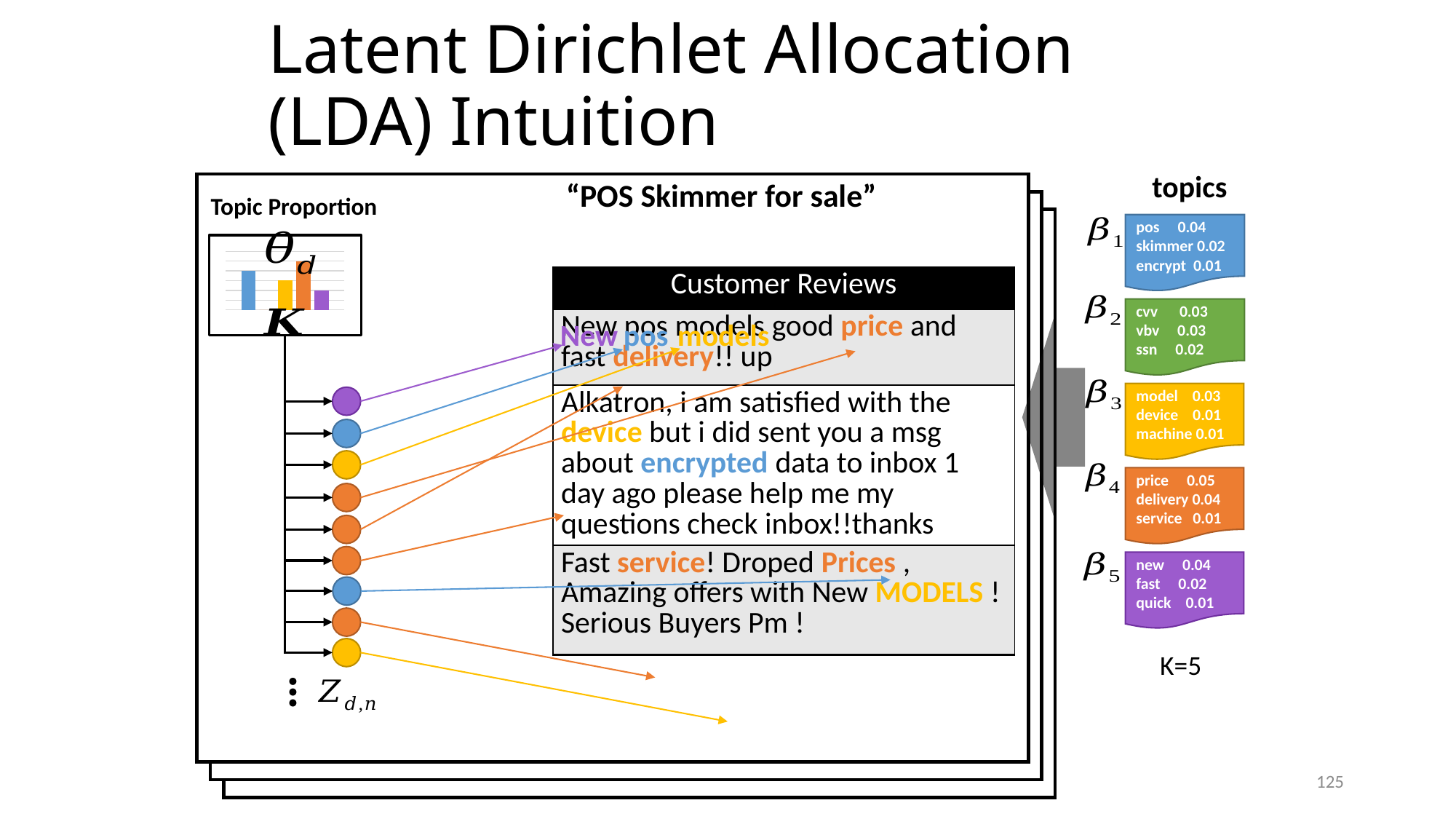
In the "Topic Proportion" chart, is the blue bar or the yellow bar taller? blue In the "Topic Proportion" chart, is the orange bar or the purple bar taller? orange What is the title of the small bar chart on the left of the slide? Topic Proportion Which coloured bar is the tallest in the "Topic Proportion" chart? orange What colours are the four bars in the "Topic Proportion" chart, from left to right? blue, yellow, orange, purple Which coloured bar is the shortest in the "Topic Proportion" chart? purple How many bars does the "Topic Proportion" chart show? 4 What kind of chart is shown in the "Topic Proportion" box? bar chart